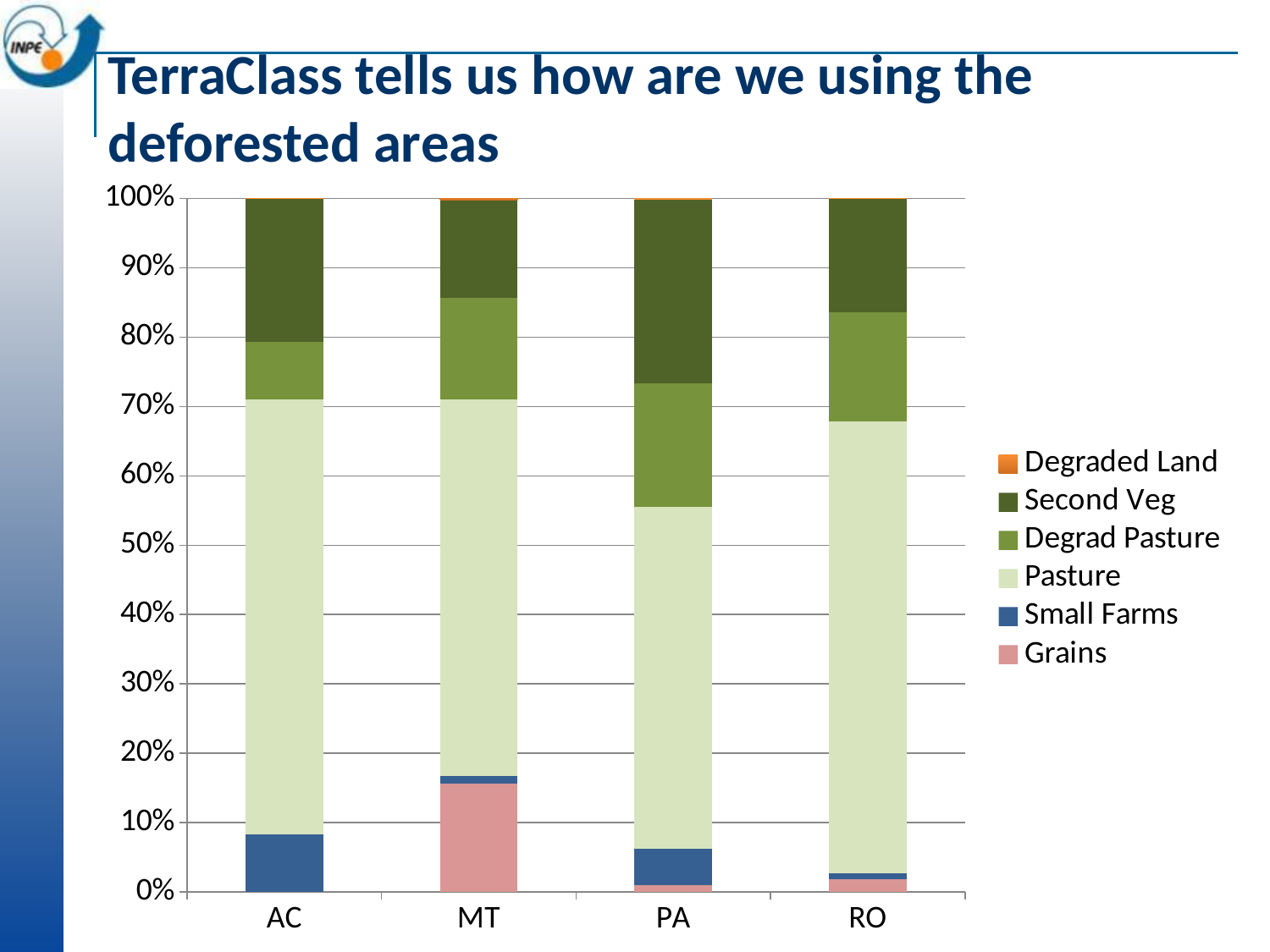
Which state has the largest Grains share? MT Is the Second Veg share for PA greater or less than 20%? greater What kind of chart is shown on the slide? Stacked bar chart Is the Second Veg share for MT greater or less than 20%? less Which state has the largest Second Veg share? PA Is the Grains share for MT greater or less than 10%? greater Which has the larger Degrad Pasture share, PA or AC? PA Which series is listed first in the legend? Degraded Land How many states (categories) are shown on the x axis? 4 What is the total height of the stacked bar for AC? 100% How many series does the legend list? 6